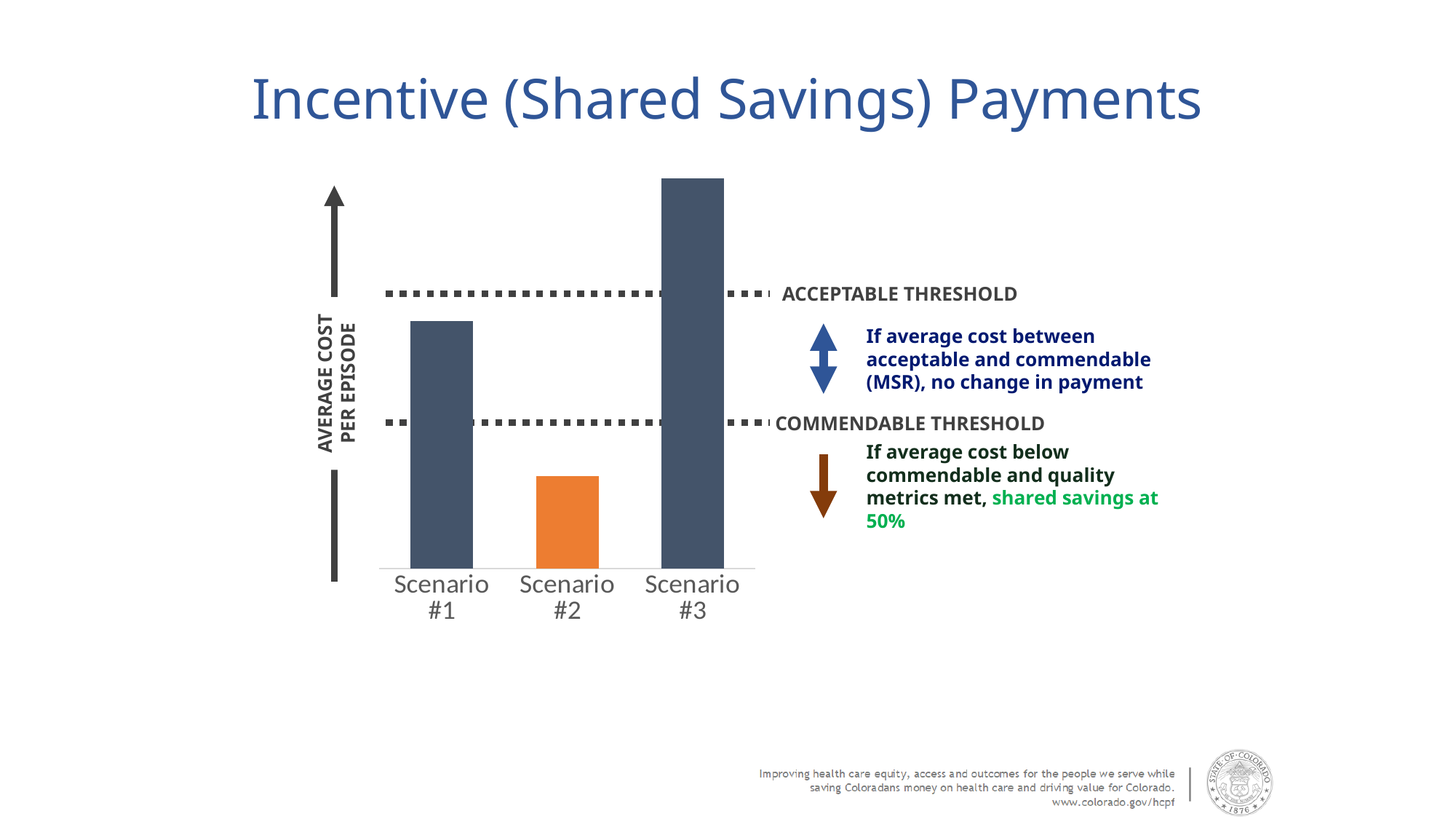
Which scenario's bar is coloured orange rather than dark blue? Scenario #2 What is the label on the vertical axis of the chart? AVERAGE COST PER EPISODE Which scenario has the lowest average cost per episode? Scenario #2 Which has a higher average cost per episode, Scenario #1 or Scenario #3? Scenario #3 Which has a higher average cost per episode, Scenario #1 or Scenario #2? Scenario #1 What kind of chart is shown on the slide? bar chart How many scenarios (bars) are plotted in the chart? 3 Which scenario has the highest average cost per episode? Scenario #3